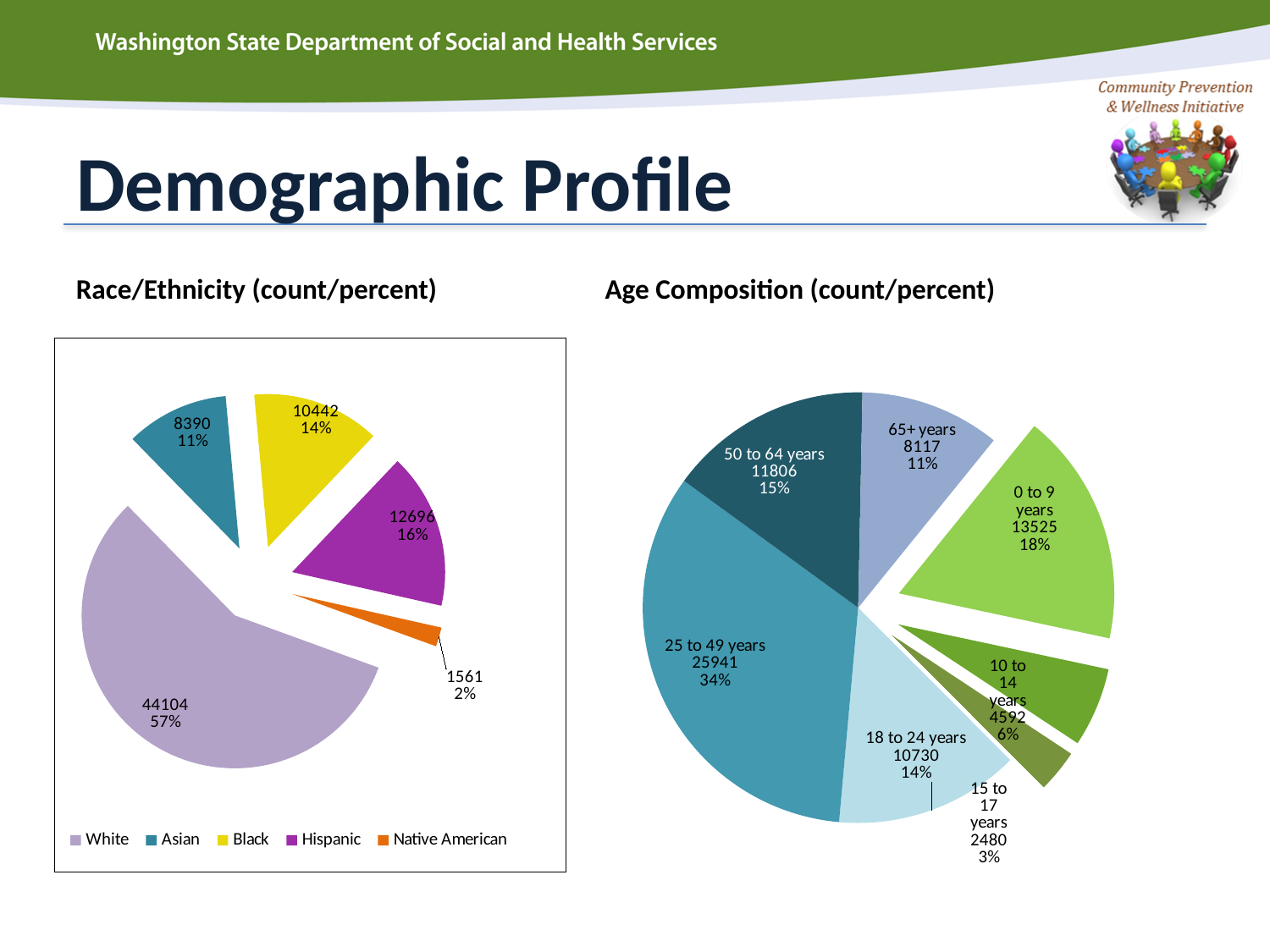
In the Race/Ethnicity chart, what is the count for White? 44104 In the Race/Ethnicity chart, how many categories does the legend list? 5 In the Age Composition chart, what is the count for 25 to 49 years? 25941 In the Race/Ethnicity chart, which category has the smallest slice? Native American In the Age Composition chart, which age group has the smallest share? 15 to 17 years In the Age Composition chart, what percent share does 18 to 24 years have? 14% In the Age Composition chart, which age group has the largest share? 25 to 49 years In the Age Composition chart, which is larger: the count for 0 to 9 years or the count for 50 to 64 years? 0 to 9 years In the Race/Ethnicity chart, what is the difference between the Black count and the Asian count? 2052 What type of chart is used for Age Composition? Pie chart In the Race/Ethnicity chart, what percent share does Hispanic have? 16% In the Race/Ethnicity chart, which colour represents Native American? Orange